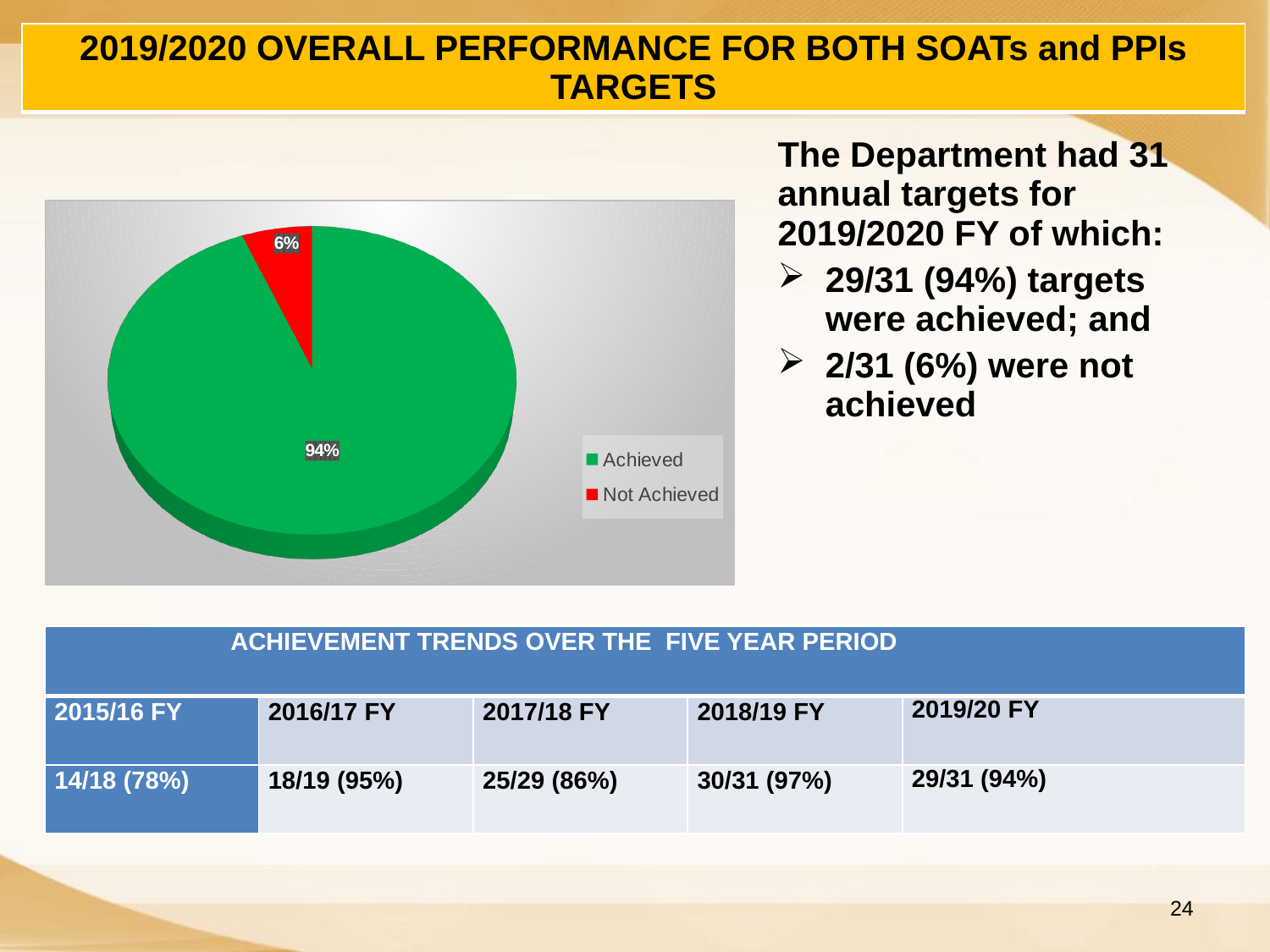
Which slice of the pie chart is the largest? Achieved What is the difference in percentage points between the Achieved and Not Achieved slices? 88 Which slice of the pie chart is the smallest? Not Achieved What colour is the Achieved slice in the pie chart? green Which is larger in the pie chart, Achieved or Not Achieved? Achieved How many entries does the pie chart's legend list? 2 What share of the pie chart is labelled Achieved? 94% How many slices does the pie chart have? 2 What share of the pie chart is labelled Not Achieved? 6% What kind of chart is shown on the slide? pie chart What colour is the Not Achieved slice in the pie chart? red